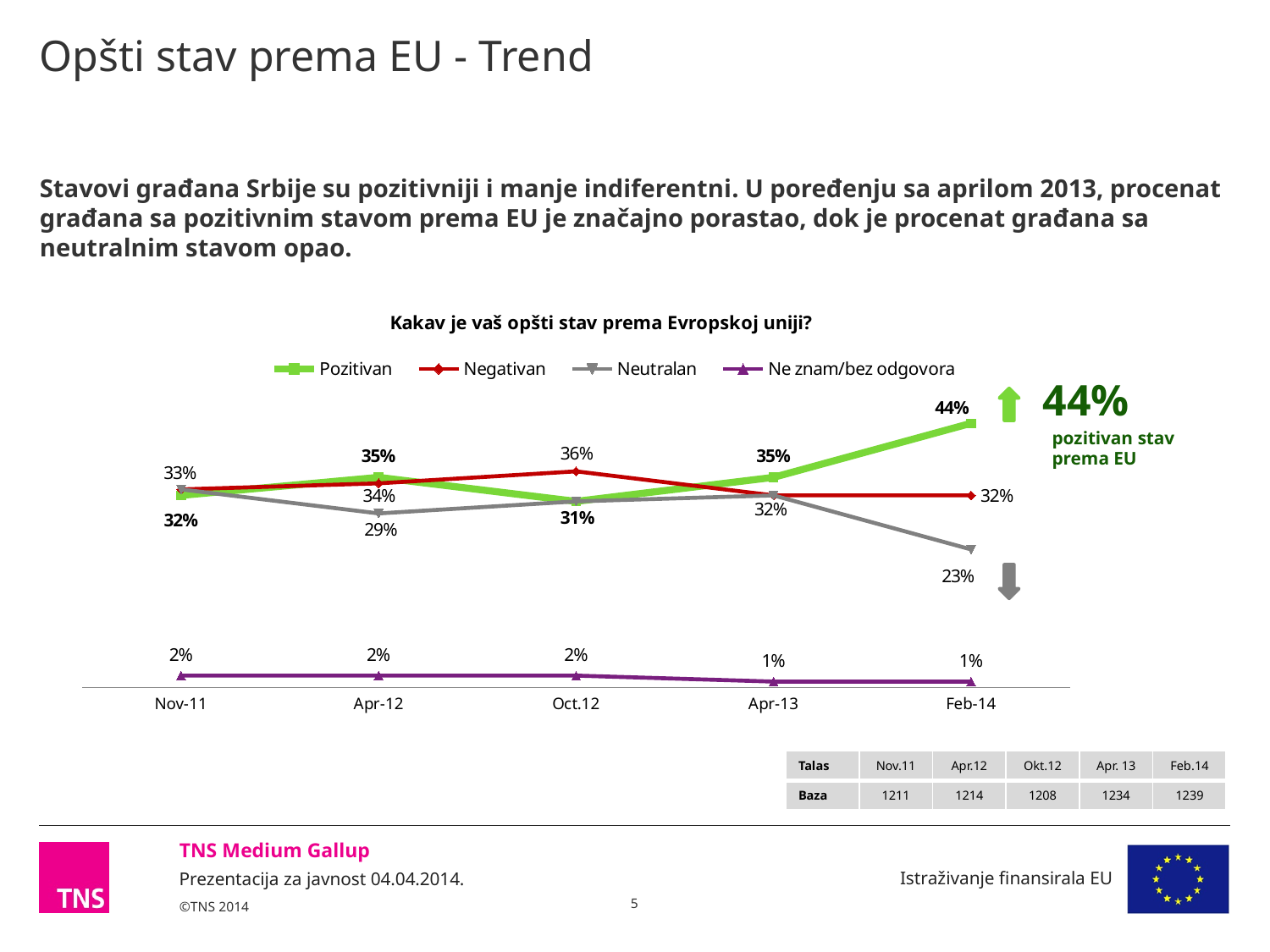
At which time point is the Pozitivan series highest? Feb-14 How many series does the legend list? 4 What kind of chart is shown on the slide? Line chart What is the value for Ne znam/bez odgovora at Feb-14? 1% What is the value for Neutralan at Apr-12? 29% What is the value for Negativan at Feb-14? 32% What is the value for Pozitivan at Feb-14? 44% How many time points are shown on the x axis? 5 What is the value for Neutralan at Feb-14? 23% What is the value for Pozitivan at Oct.12? 31% By how many percentage points did Pozitivan change from Apr-13 to Feb-14? 9 percentage points At Feb-14, which is larger: Pozitivan or Neutralan? Pozitivan